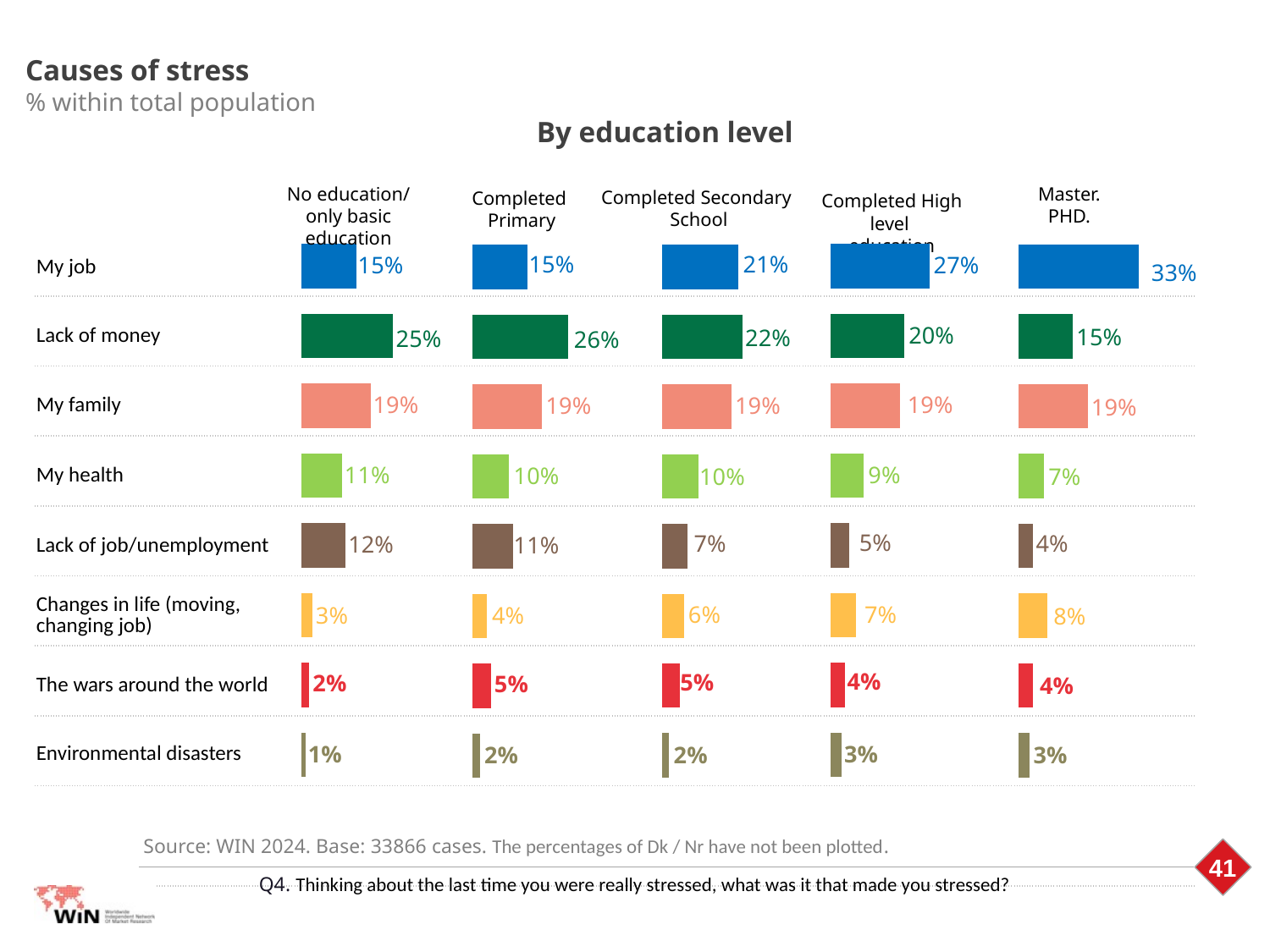
What percentage of respondents with a Master or PhD cite 'My job' as a cause of stress? 33% Which education level has the highest value for 'My job'? Master. PHD. What is the value for 'Lack of money' among those who completed primary education? 26% Which education level has the lowest value for 'Lack of money'? Master. PHD. What type of chart is used to show the values on this slide? Bar chart What is the value for 'My family' across all five education levels? 19% What is the difference between the 'My job' values for Master/PhD and for no education/only basic education? 18 percentage points How do the values for 'Lack of job/unemployment' change from left to right across education levels? They fall How do the values for 'My job' change as education level increases from left to right? They rise What is the value for 'Lack of job/unemployment' among those with no education/only basic education? 12% Among those who completed secondary school, which is larger: 'My job' or 'Lack of money'? Lack of money How many causes of stress are listed in the chart? 8